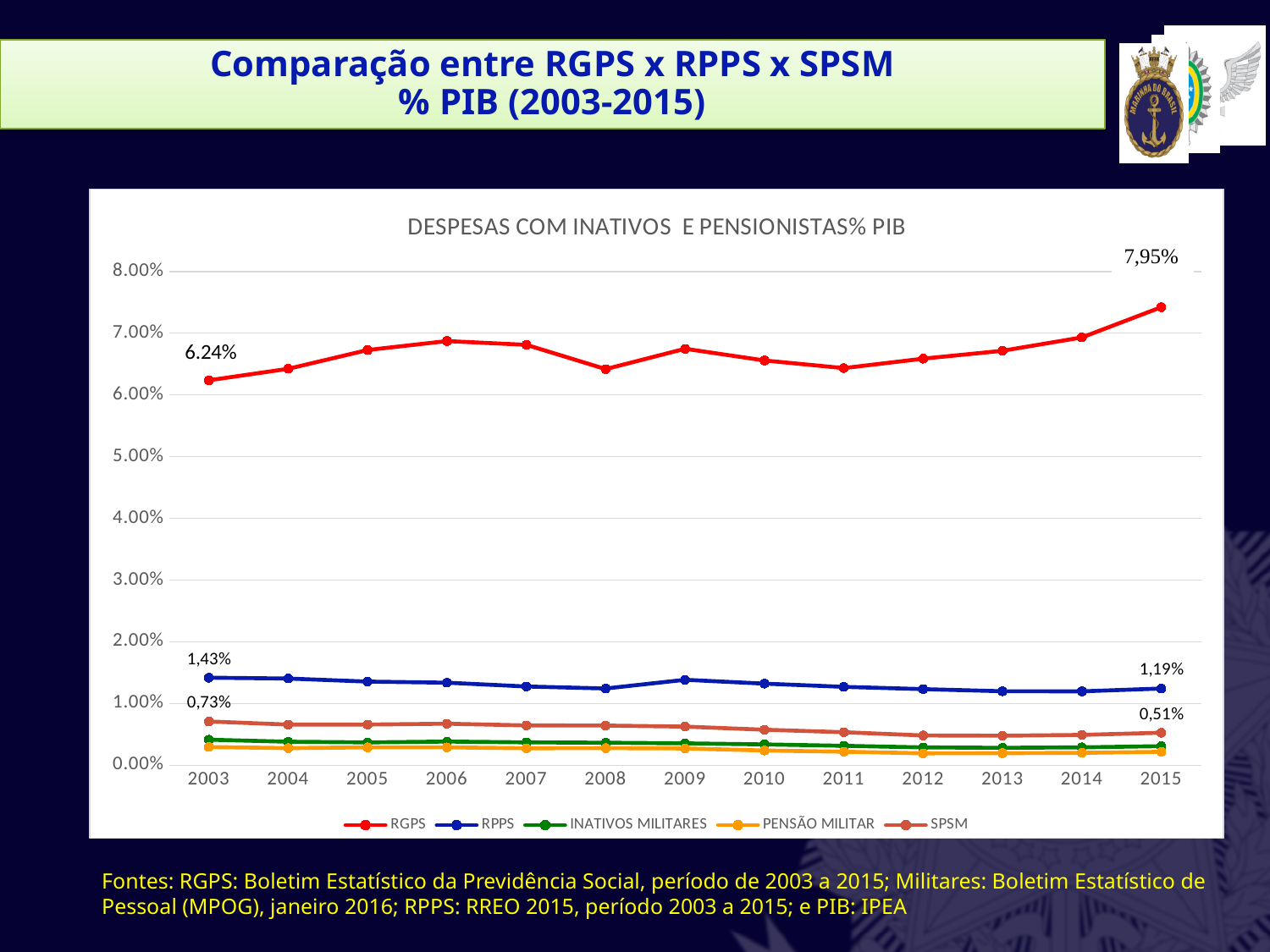
What is the title of the chart? DESPESAS COM INATIVOS E PENSIONISTAS% PIB Is the value for RGPS in 2012 greater or less than 6.00%? greater What is the value for RGPS in 2015? 7,95% Which is larger, the RPPS value in 2003 or the RPPS value in 2015? 2003 How many series does the legend list? 5 What is the value for RPPS in 2003? 1,43% What is the value for SPSM in 2015? 0,51% How many years are shown on the x axis? 13 What type of chart is shown on the slide? line chart What is the value for RGPS in 2003? 6.24% Does the SPSM series rise or fall from 2003 to 2015? fall Which series has the highest values across all years? RGPS